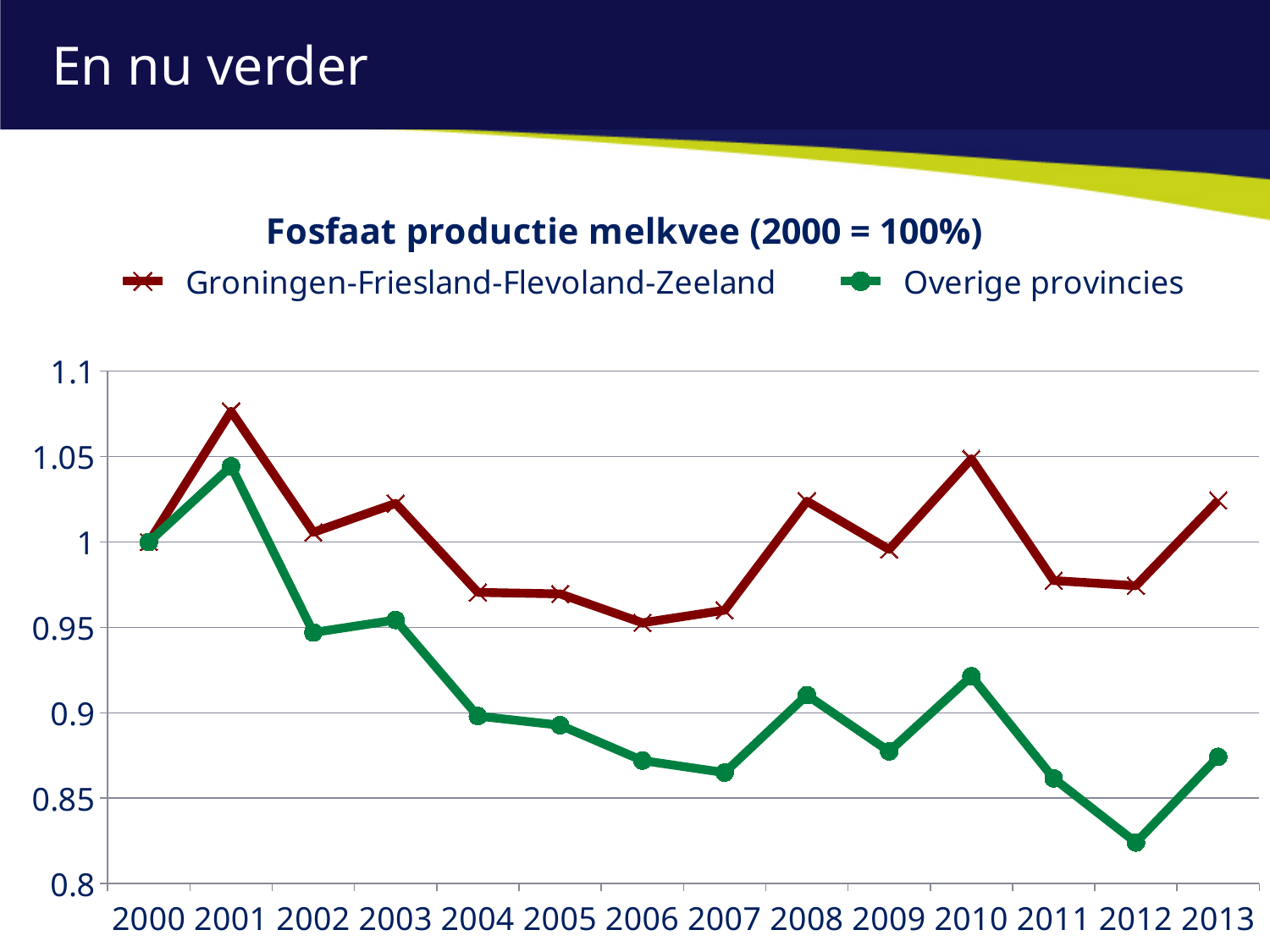
In 2013, which series has the higher value: Groningen-Friesland-Flevoland-Zeeland or Overige provincies? Groningen-Friesland-Flevoland-Zeeland Is the value for Overige provincies in 2012 greater or less than 0.85? less What is the value for Overige provincies in 2000? 1 How many series does the legend list? 2 What type of chart is shown on the slide? line chart Does the Overige provincies series overall rise or fall from 2000 to 2013? fall Is the value for Groningen-Friesland-Flevoland-Zeeland in 2001 greater or less than 1.05? greater How many years are plotted along the x axis? 14 What is the title of the chart? Fosfaat productie melkvee (2000 = 100%) In which year does the Groningen-Friesland-Flevoland-Zeeland series reach its highest value? 2001 In which year does the Overige provincies series reach its lowest value? 2012 Is the value for Overige provincies in 2006 greater or less than 0.9? less